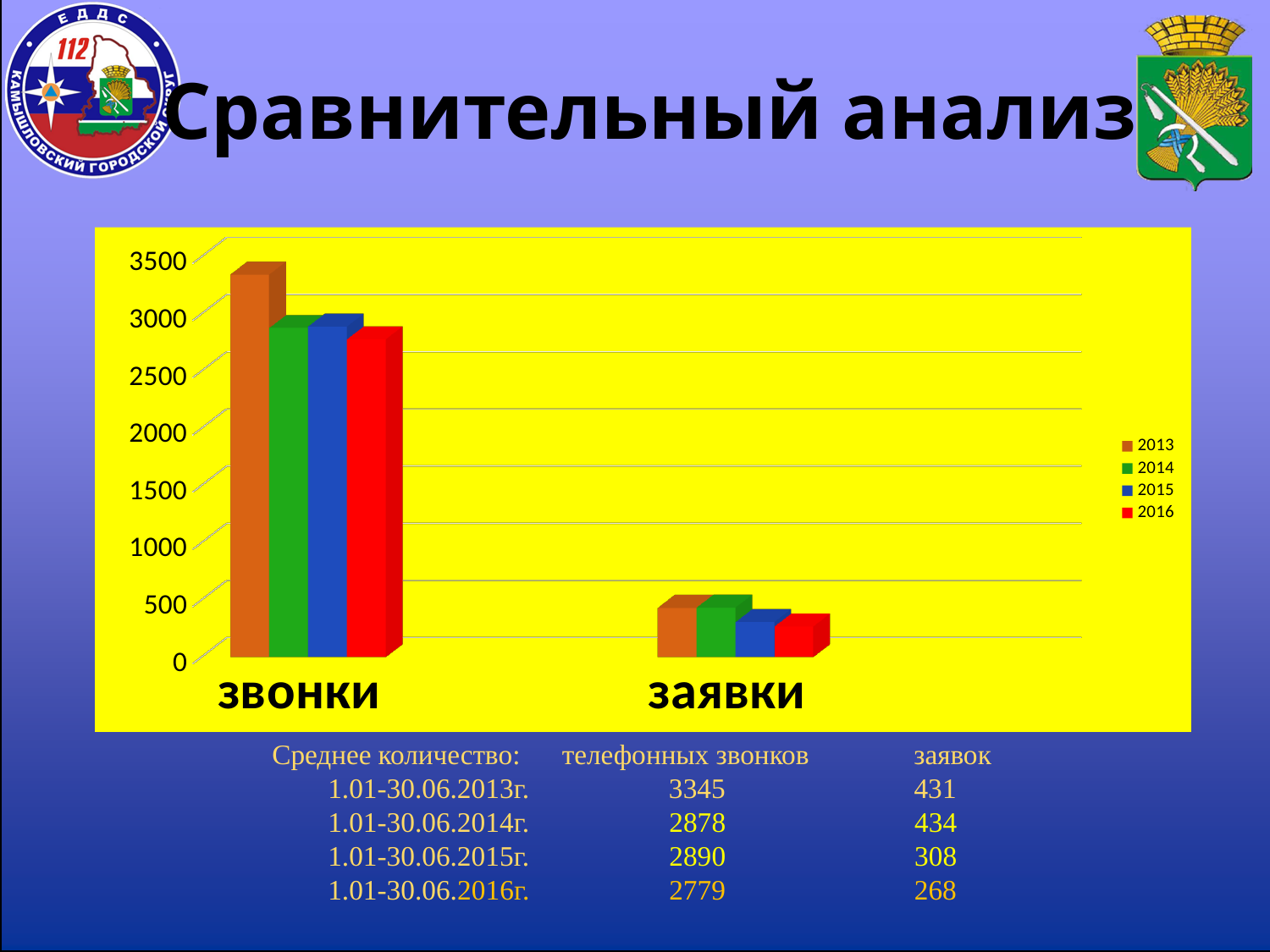
How many series does the chart legend list? 4 Which is larger, the 2013 bar for звонки or the 2013 bar for заявки? звонки How many categories are shown on the x axis of the chart? 2 Is the 2013 bar for звонки greater or less than 3000? greater Is the 2013 bar for заявки greater or less than 500? less What is the title of the slide containing the chart? Сравнительный анализ Which colour represents the 2016 series in the chart legend? red Is the 2014 bar for звонки greater or less than 2500? greater What kind of chart is shown on the slide? bar chart Which is larger, the 2016 bar for звонки or the 2016 bar for заявки? звонки Which year has the highest bar for звонки? 2013